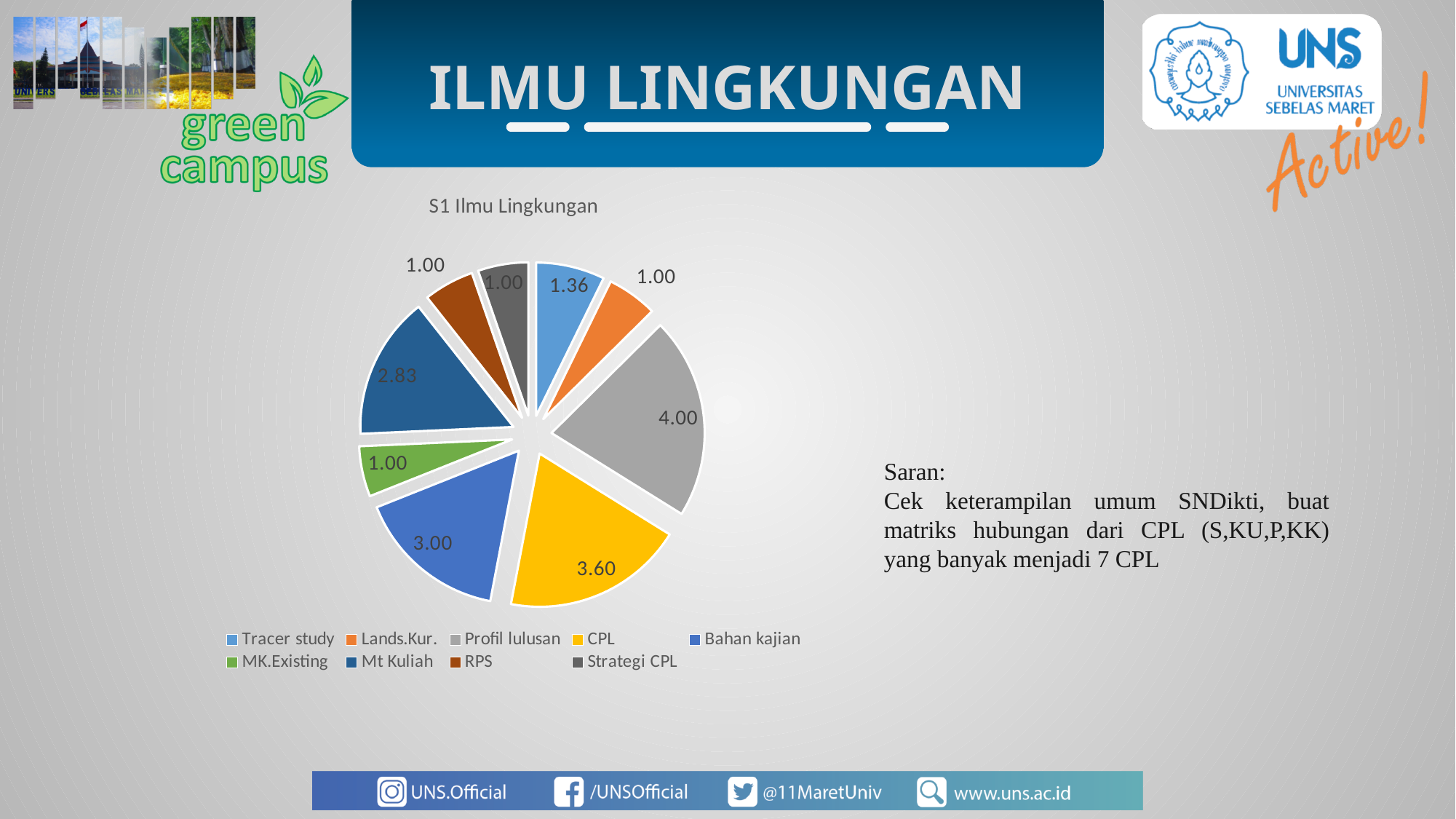
What type of chart is shown on the slide? pie chart What is the difference between the values for Profil lulusan and CPL? 0.40 Which category has the largest slice? Profil lulusan Which is larger, the value for Bahan kajian or the value for Mt Kuliah? Bahan kajian What is the title of the chart? S1 Ilmu Lingkungan What is the value for Bahan kajian? 3.00 What is the value for Mt Kuliah? 2.83 What is the value for Tracer study? 1.36 What colour is the slice for CPL? yellow What is the value for CPL? 3.60 What is the value for Profil lulusan? 4.00 How many categories does the legend list? 9